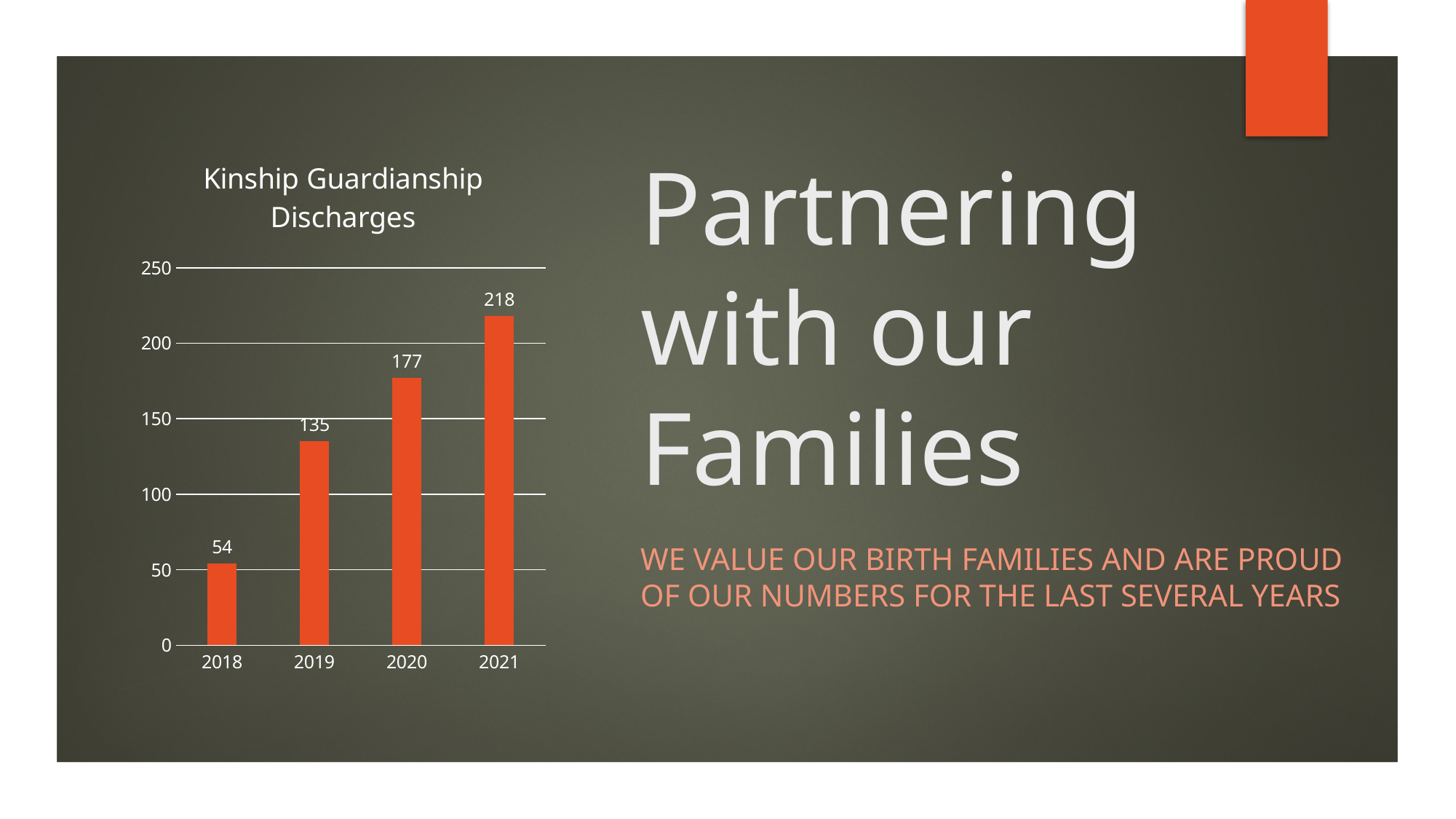
What is the value for 2018 in the Kinship Guardianship Discharges chart? 54 Which year has a larger value in the Kinship Guardianship Discharges chart, 2019 or 2020? 2020 Do the values in the Kinship Guardianship Discharges chart rise or fall from 2018 to 2021? Rise What is the value for 2019 in the Kinship Guardianship Discharges chart? 135 What is the title of the chart on the slide? Kinship Guardianship Discharges How many years are shown in the Kinship Guardianship Discharges chart? 4 What is the value for 2020 in the Kinship Guardianship Discharges chart? 177 Which year has the highest number of Kinship Guardianship Discharges? 2021 What type of chart is the Kinship Guardianship Discharges chart? Bar chart What is the value for 2021 in the Kinship Guardianship Discharges chart? 218 Which year has the lowest number of Kinship Guardianship Discharges? 2018 What is the difference between the 2021 and 2018 values in the Kinship Guardianship Discharges chart? 164